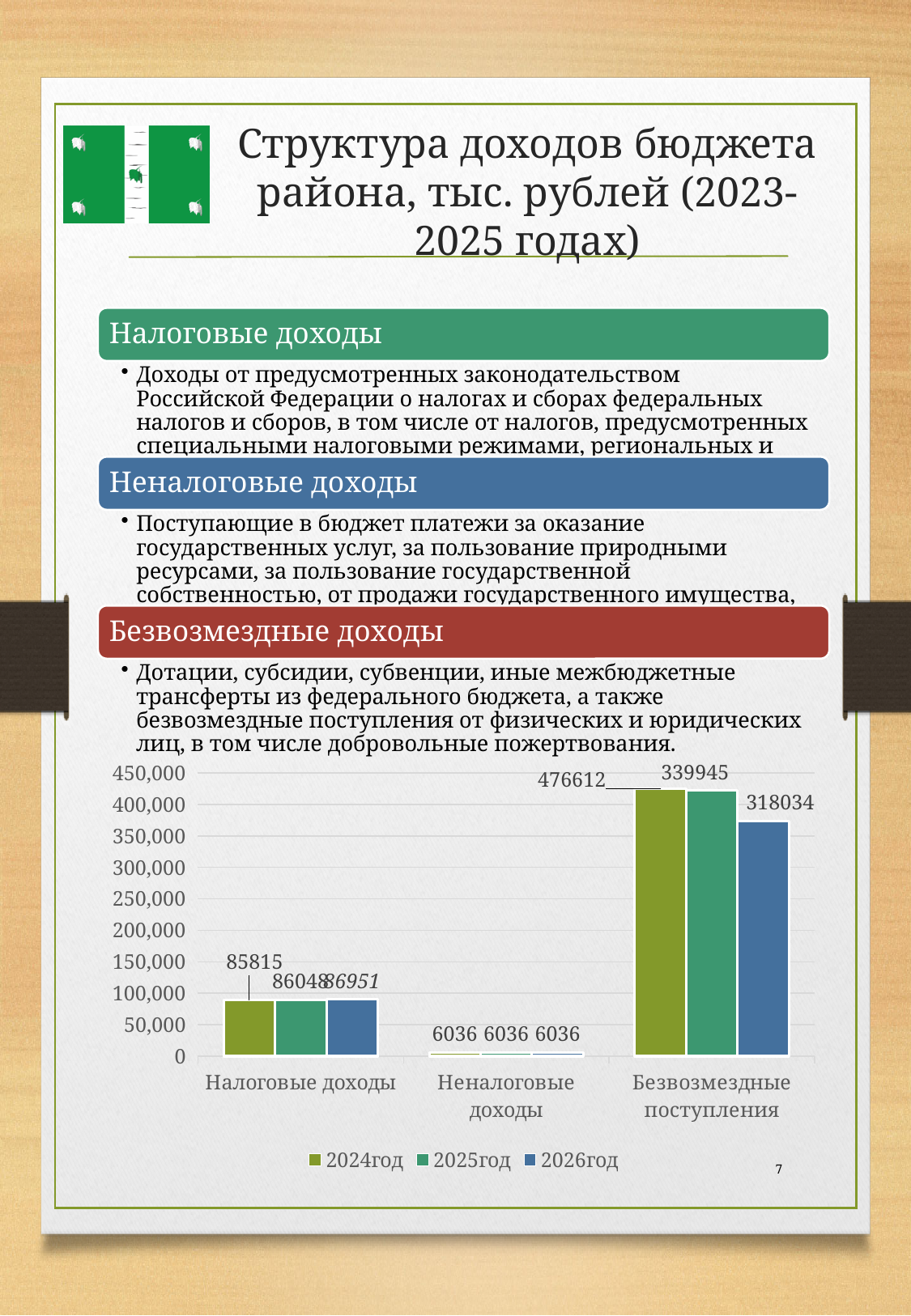
For Безвозмездные поступления, which is larger: the 2024год value or the 2026год value? 2024год What is the value for Неналоговые доходы in 2025год? 6036 How many series does the chart legend list? 3 Which category has the lowest value for 2026год? Неналоговые доходы What is the value for Налоговые доходы in 2026год? 86951 What is the value for Безвозмездные поступления in 2026год? 318034 What kind of chart is shown on the slide? bar chart Which category has the highest value for 2024год? Безвозмездные поступления How many categories are shown on the x axis of the chart? 3 What is the difference between the 2026год and 2024год values for Налоговые доходы? 1136 What is the value for Налоговые доходы in 2024год? 85815 Is the value for Налоговые доходы in 2025год greater or less than 100,000? less